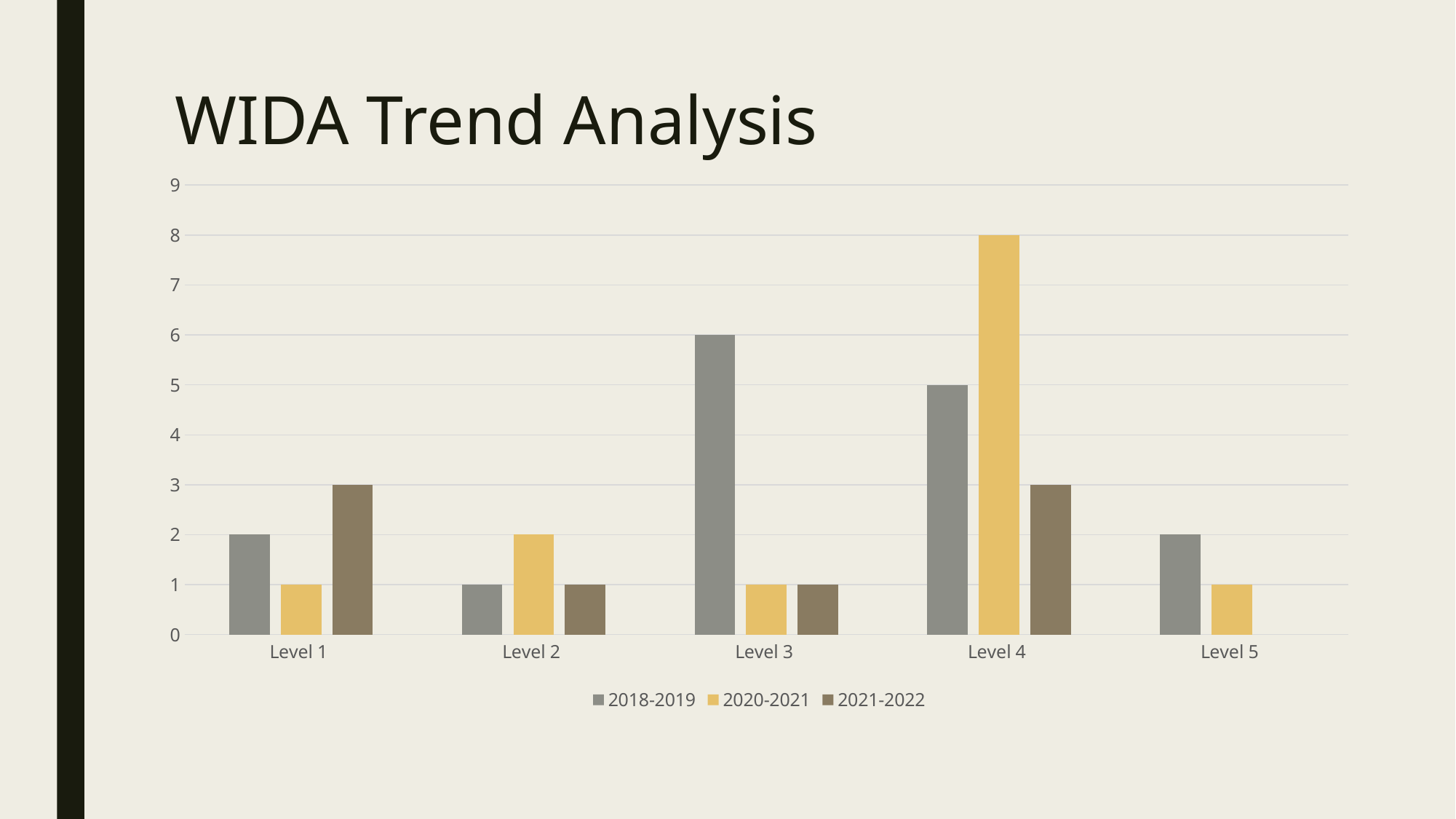
What is the value for 2020-2021 at Level 4? 8 How many series does the legend list? 3 Is the value for 2020-2021 at Level 4 greater or less than 7? greater What is the value for 2021-2022 at Level 1? 3 Which level has the highest value for the 2018-2019 series? Level 3 How many level categories are shown on the x axis? 5 What is the value for 2018-2019 at Level 3? 6 At Level 1, which is larger: the 2018-2019 value or the 2021-2022 value? 2021-2022 Which level has the highest value for the 2020-2021 series? Level 4 What is the difference between the 2020-2021 and 2018-2019 values at Level 4? 3 What is the title of the chart? WIDA Trend Analysis What type of chart is shown on the slide? Bar chart